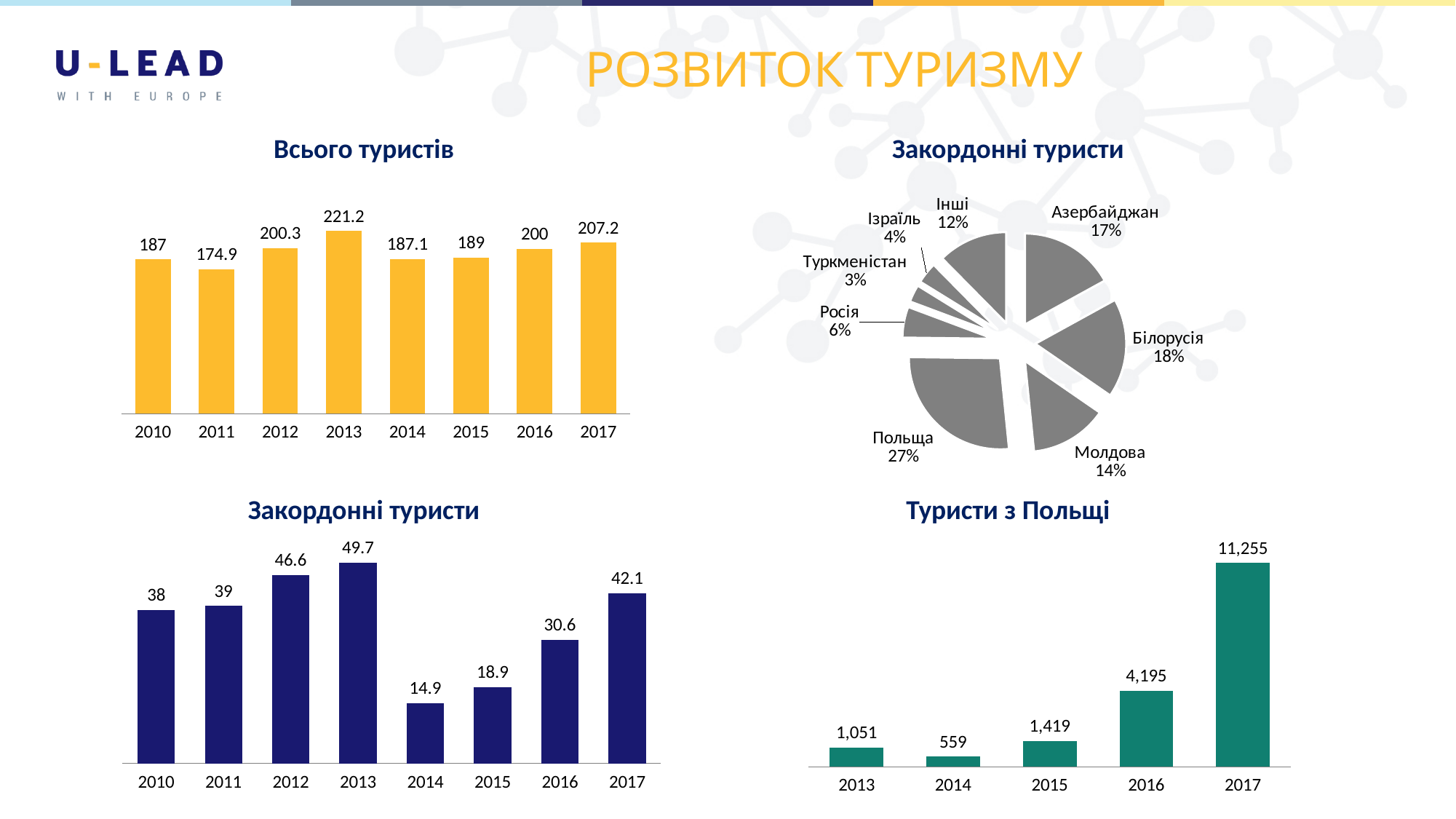
What type of chart is 'Туристи з Польщі' (bottom right)? Bar chart In the 'Туристи з Польщі' chart (bottom right), what is the value for 2017? 11,255 In the pie chart 'Закордонні туристи' (top right), which is larger: the share for Білорусія or the share for Азербайджан? Білорусія In the 'Всього туристів' chart (top left), what is the difference between the values for 2017 and 2016? 7.2 In the pie chart 'Закордонні туристи' (top right), what share does Польща have? 27% In the 'Всього туристів' chart (top left), what is the value for 2013? 221.2 In the bar chart 'Закордонні туристи' (bottom left), which year has the highest value? 2013 In the 'Всього туристів' chart (top left), which year has the lowest value? 2011 In the bar chart 'Закордонні туристи' (bottom left), what is the value for 2014? 14.9 In the 'Туристи з Польщі' chart (bottom right), which year has the lowest value? 2014 In the pie chart 'Закордонні туристи' (top right), which country has the smallest share? Туркменістан In the 'Всього туристів' chart (top left), how many years are shown? 8